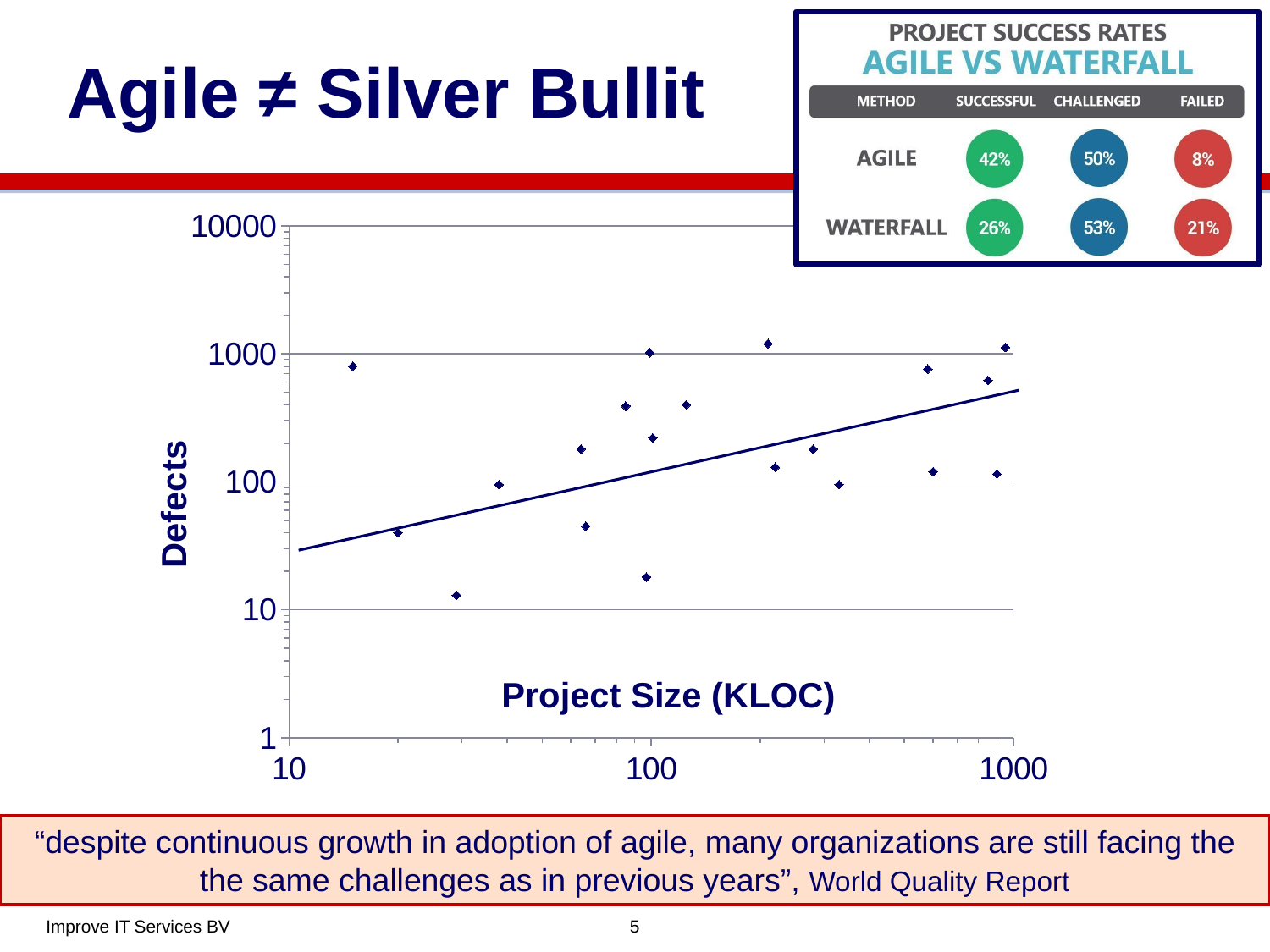
What kind of chart is the Defects versus Project Size chart? Scatter chart In the scatter chart, is any plotted point greater than 10000 defects? No In the Project Success Rates Agile vs Waterfall table, what is the failed rate for Waterfall? 21% In the Project Success Rates Agile vs Waterfall table, how many percentage points higher is the Agile successful rate than the Waterfall successful rate? 16 In the scatter chart, what is the largest tick value shown on the Project Size (KLOC) axis? 1000 In the scatter chart, what is the title of the horizontal axis? Project Size (KLOC) In the scatter chart, is the lowest plotted defect value greater or less than 100? less In the Project Success Rates Agile vs Waterfall table, which method has the higher challenged rate? Waterfall In the scatter chart, does the trend line show defects rising or falling as project size increases? Rising In the Project Success Rates Agile vs Waterfall table, what is the successful rate for Agile? 42% In the scatter chart, what is the highest tick value shown on the Defects axis? 10000 In the scatter chart, what is the title of the vertical axis? Defects